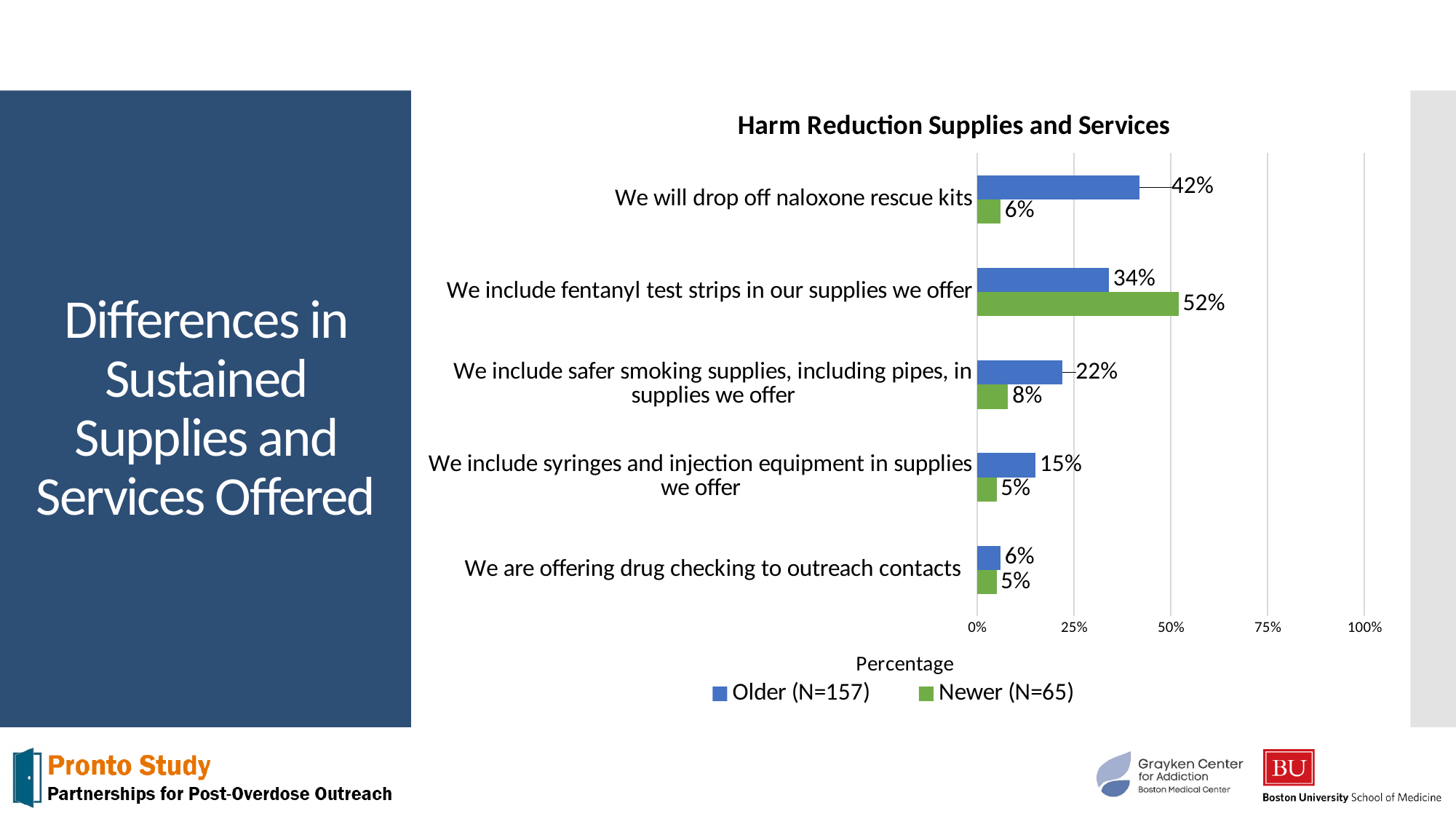
What is the title of the chart? Harm Reduction Supplies and Services Which category has the lowest value for the Older (N=157) series? We are offering drug checking to outreach contacts How many series does the legend list? 2 What is the value for Newer (N=65) for "We include safer smoking supplies, including pipes, in supplies we offer"? 8% What is the value for Newer (N=65) for "We include fentanyl test strips in our supplies we offer"? 52% What is the value for Older (N=157) for "We will drop off naloxone rescue kits"? 42% What is the difference between the Older and Newer values for "We will drop off naloxone rescue kits"? 36% For "We include fentanyl test strips in our supplies we offer", which series has the larger value, Older (N=157) or Newer (N=65)? Newer (N=65) Which category has the highest value for the Older (N=157) series? We will drop off naloxone rescue kits Is the Older (N=157) value for "We include syringes and injection equipment in supplies we offer" greater or less than 25%? less How many categories are shown on the chart? 5 What kind of chart is shown on the slide? Bar chart